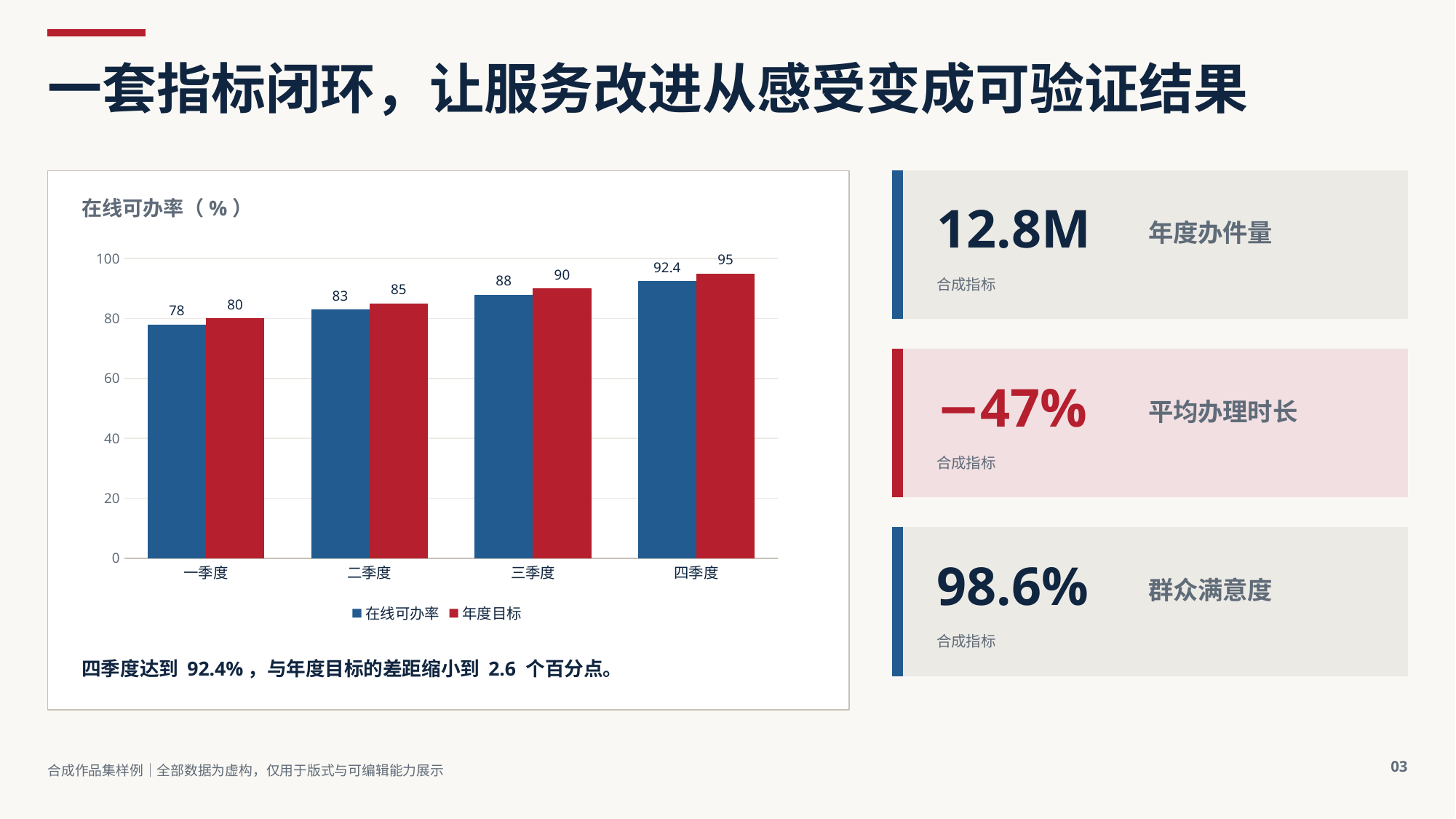
What is the 在线可办率 value for 一季度? 78 How many quarters are shown on the x axis? 4 What is the 在线可办率 value for 四季度? 92.4 Which is larger for 二季度, the 在线可办率 or the 年度目标? 年度目标 What is the 年度目标 value for 三季度? 90 How many series does the legend list? 2 What is the difference between the 在线可办率 for 三季度 and 二季度? 5 Which quarter has the highest 在线可办率? 四季度 What is the difference between the 年度目标 and the 在线可办率 for 四季度? 2.6 Does the 在线可办率 rise or fall from 一季度 to 四季度? rise Which quarter has the lowest 年度目标? 一季度 What kind of chart is shown? bar chart